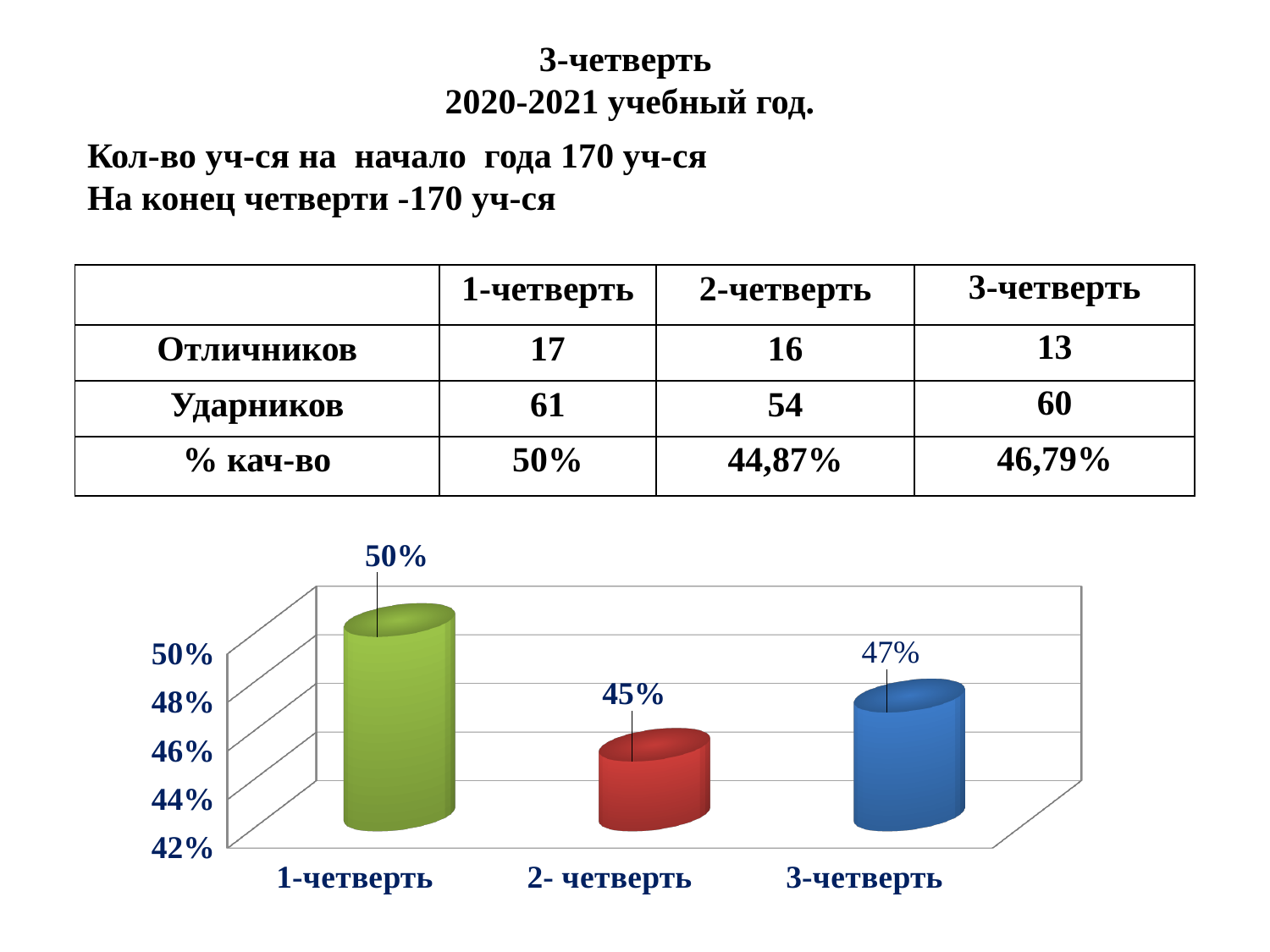
Is the value for 3-четверть in the chart greater or less than 46%? greater What is the difference between the values for 1-четверть and 2- четверть in the chart? 5% Which category has the lowest value in the chart? 2- четверть Which category has the highest value in the chart? 1-четверть What value is shown for 3-четверть in the chart? 47% What value is shown for 1-четверть in the chart? 50% How many categories are plotted in the chart? 3 What value is shown for 2- четверть in the chart? 45% What kind of chart is shown on the slide? Bar chart What colour is the bar for 2- четверть in the chart? Red Do the values in the chart rise or fall from 1-четверть to 2- четверть? Fall Which is larger in the chart: the value for 3-четверть or the value for 2- четверть? 3-четверть